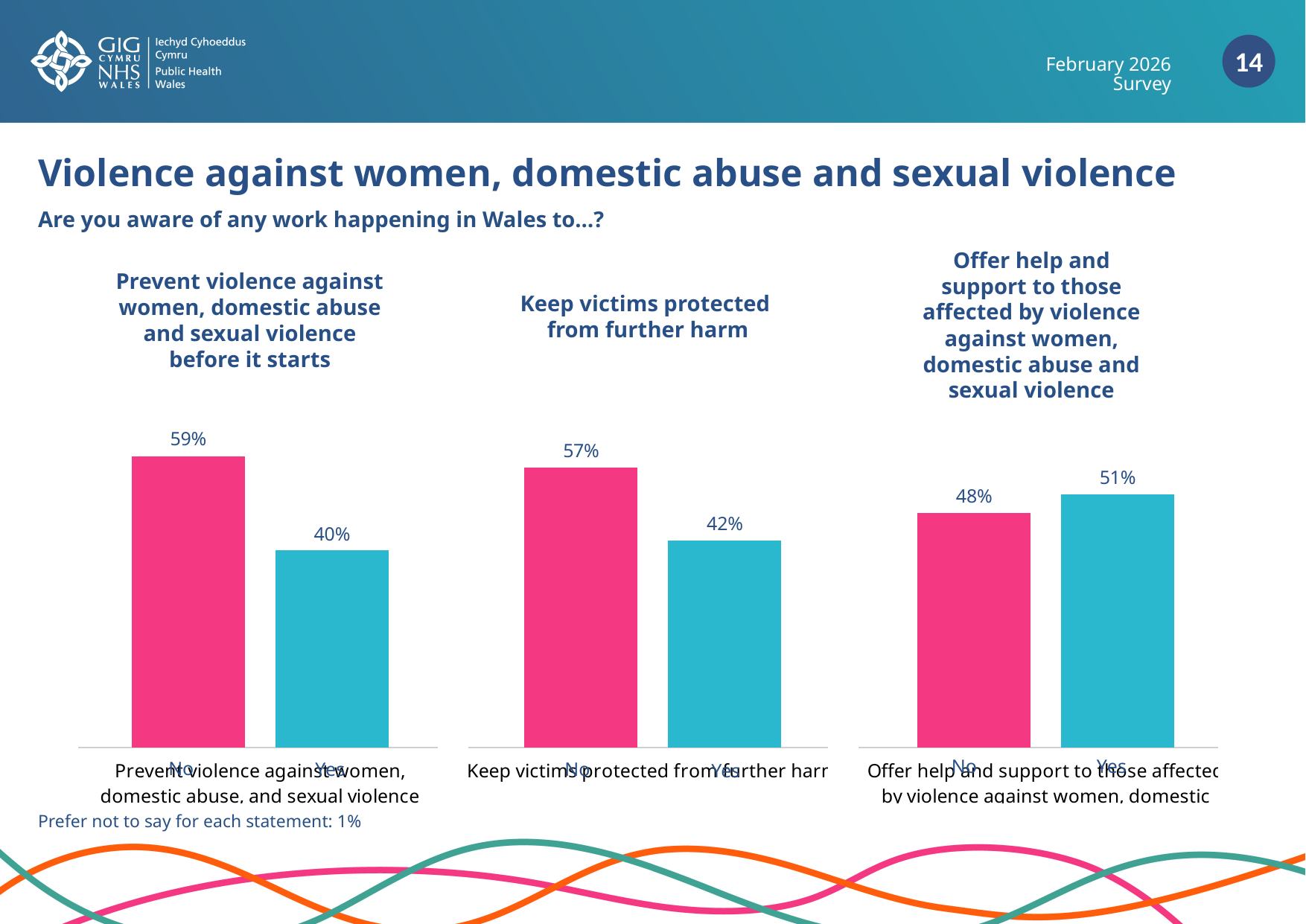
In the right chart, 'Offer help and support to those affected by violence against women, domestic abuse and sexual violence', what percentage answered No? 48% In the left chart, 'Prevent violence against women, domestic abuse and sexual violence before it starts', what percentage answered Yes? 40% In the middle chart, 'Keep victims protected from further harm', what percentage answered No? 57% In the middle chart, 'Keep victims protected from further harm', which response is higher, No or Yes? No In the right chart, 'Offer help and support to those affected by violence against women, domestic abuse and sexual violence', what percentage answered Yes? 51% In the left chart, 'Prevent violence against women, domestic abuse and sexual violence before it starts', what is the difference between the No and Yes percentages? 19% How many bars are shown in the left chart, 'Prevent violence against women, domestic abuse and sexual violence before it starts'? 2 In the left chart, 'Prevent violence against women, domestic abuse and sexual violence before it starts', what percentage answered No? 59% What type of chart is the middle chart, 'Keep victims protected from further harm'? Bar chart In the middle chart, 'Keep victims protected from further harm', what is the difference between the No and Yes percentages? 15% In the right chart, 'Offer help and support to those affected by violence against women, domestic abuse and sexual violence', which response has the highest value? Yes In the middle chart, 'Keep victims protected from further harm', what percentage answered Yes? 42%